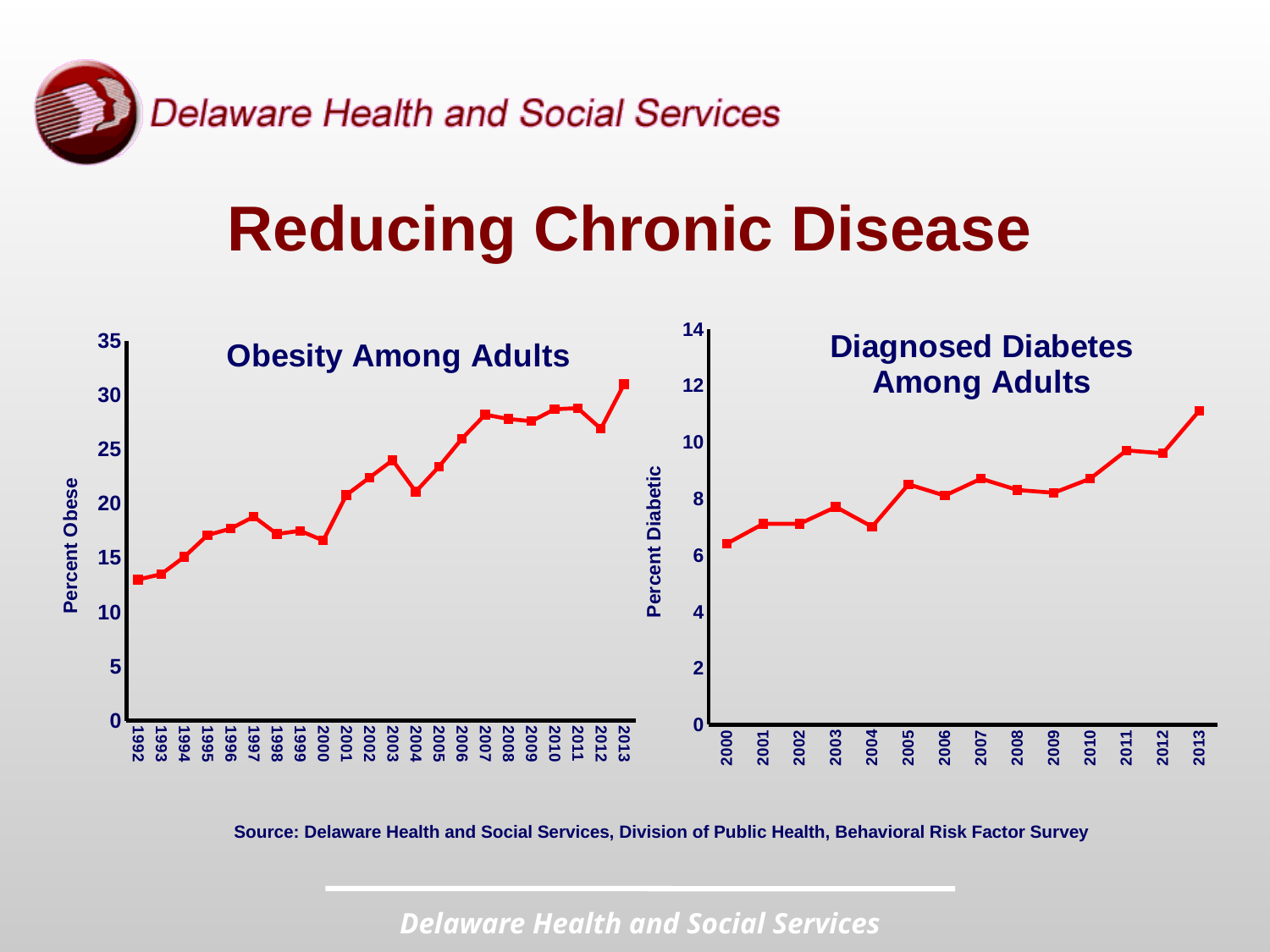
On the Diagnosed Diabetes Among Adults chart, which year has the highest percent diabetic? 2013 On the Obesity Among Adults chart, is the value for 2013 greater or less than 30? greater What kind of chart is the Obesity Among Adults chart? line chart Overall, do the values on the Diagnosed Diabetes Among Adults chart rise or fall from 2000 to 2013? rise On the Obesity Among Adults chart, which year has the lowest percent obese? 1992 How many years are plotted on the Diagnosed Diabetes Among Adults chart? 14 On the Obesity Among Adults chart, which year has the highest percent obese? 2013 On the Diagnosed Diabetes Among Adults chart, is the value for 2013 greater or less than 10? greater On the Obesity Among Adults chart, is the value for 2000 greater or less than 20? less On the Diagnosed Diabetes Among Adults chart, which year has the lowest percent diabetic? 2000 How many years are plotted on the Obesity Among Adults chart? 22 On the Obesity Among Adults chart, which year has the higher value, 2003 or 2004? 2003